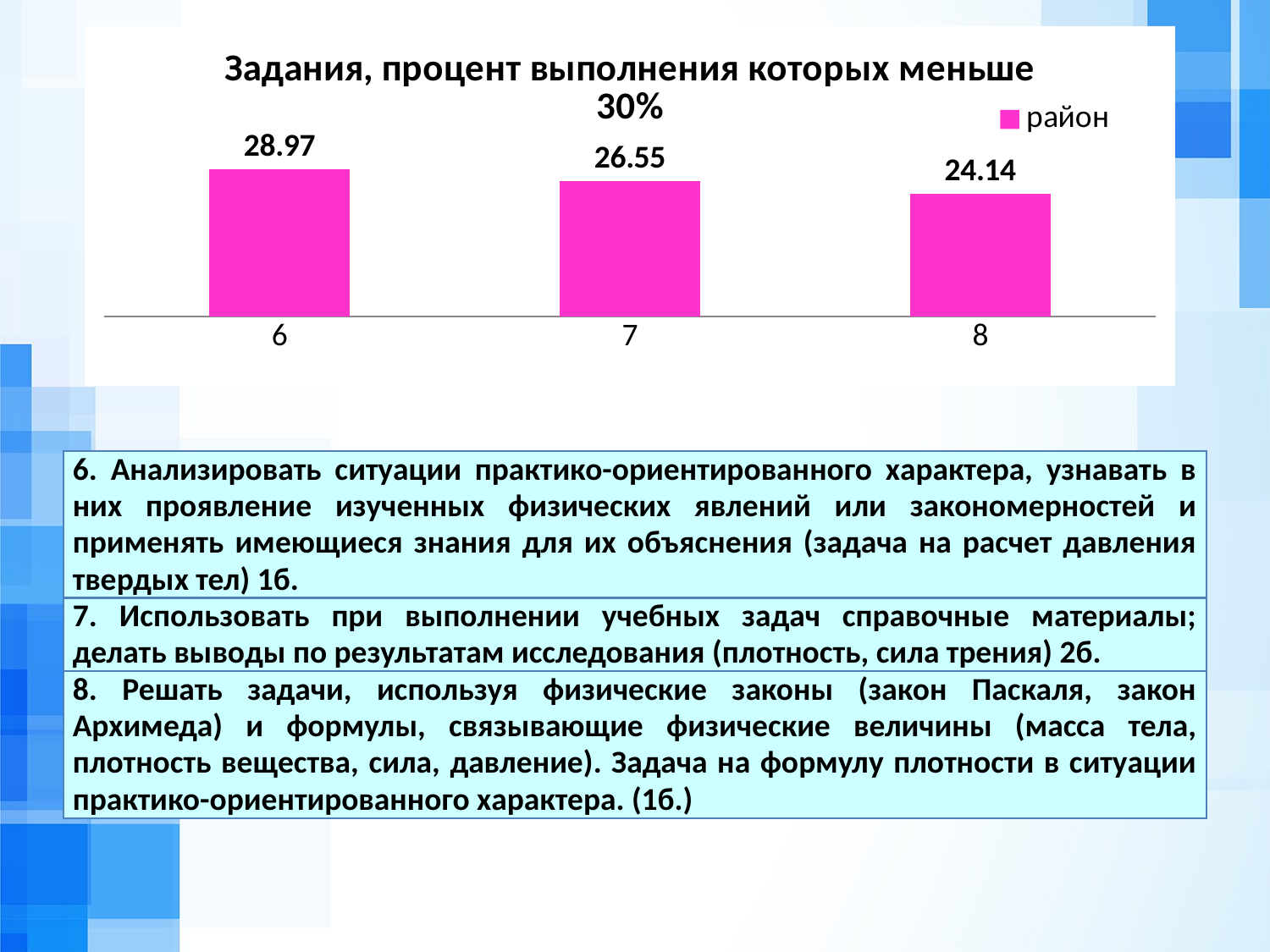
What is the value for category 6? 28.97 What is the difference between the values for category 6 and category 8? 4.83 What is the value for category 7? 26.55 What is the value for category 8? 24.14 Which category has the highest value? 6 What kind of chart is shown on the slide? bar chart What is the difference between the values for category 7 and category 8? 2.41 Do the values rise or fall from category 6 to category 8? fall Which category has the lowest value? 8 Which is larger, the value for category 6 or category 7? 6 How many categories are shown on the chart? 3 How many series does the legend list? 1